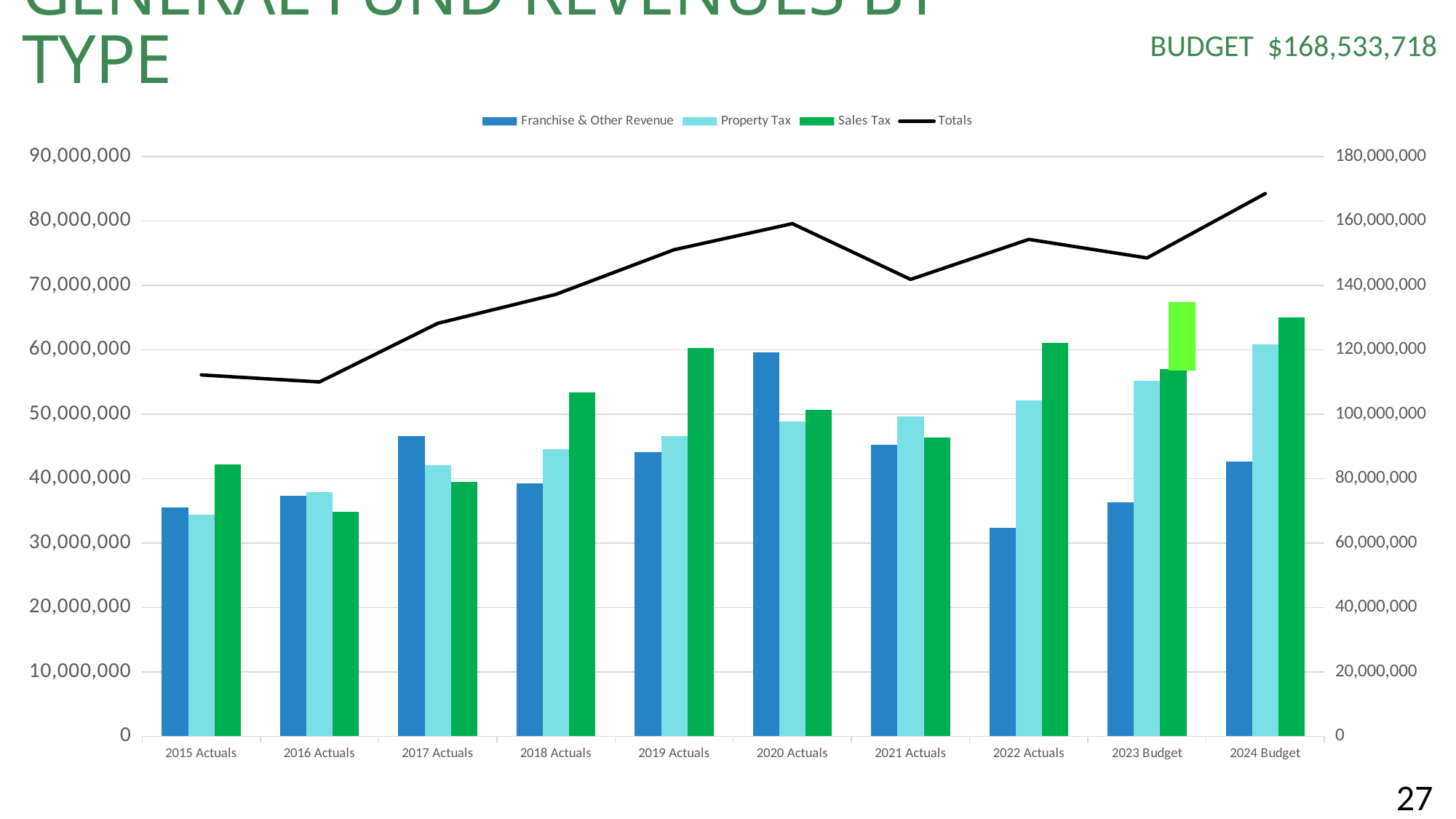
Which category has the highest Property Tax bar? 2024 Budget Is the Franchise & Other Revenue value for 2020 Actuals greater or less than 50,000,000? greater Do the Property Tax values rise or fall from 2015 Actuals to 2024 Budget? Rise How many series does the legend list? 4 Which category has the lowest Franchise & Other Revenue bar? 2022 Actuals Which category has the highest Franchise & Other Revenue bar? 2020 Actuals What kind of chart is used for the revenue types (Franchise & Other Revenue, Property Tax, Sales Tax)? Bar chart Is the Sales Tax value for 2016 Actuals greater or less than 40,000,000? less Which category has the lowest Sales Tax bar? 2016 Actuals In 2019 Actuals, which is larger: Sales Tax or Franchise & Other Revenue? Sales Tax Is the Totals value for 2024 Budget greater or less than 160,000,000 on the right axis? greater How many categories are shown on the x axis? 10